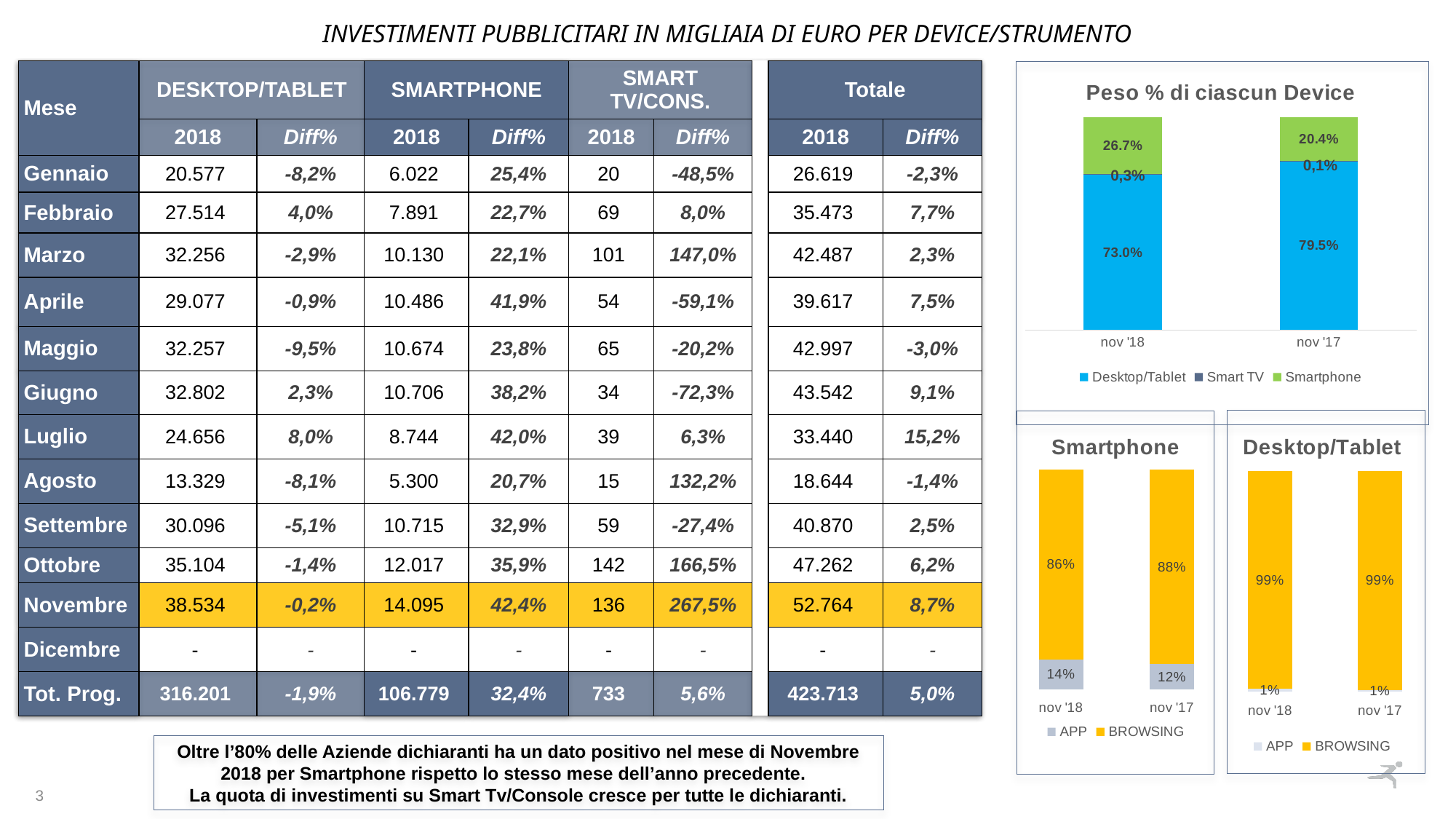
In the 'Desktop/Tablet' chart, how many bars are plotted? 2 In the 'Smartphone' chart, is the APP share larger in nov '18 or nov '17? nov '18 In the 'Desktop/Tablet' chart, what is the BROWSING share for nov '18? 99% In the 'Peso % di ciascun Device' chart, what is the Smartphone share for nov '17? 20.4% In the 'Peso % di ciascun Device' chart, what is the Smart TV share for nov '18? 0.3% In the 'Peso % di ciascun Device' chart, what is the Desktop/Tablet share for nov '18? 73.0% What type of chart is the 'Smartphone' chart? Stacked bar chart In the 'Peso % di ciascun Device' chart, how many series does the legend list? 3 In the 'Smartphone' chart, what is the APP share for nov '18? 14% In the 'Smartphone' chart, what is the BROWSING share for nov '17? 88% In the 'Peso % di ciascun Device' chart, by how many percentage points did the Smartphone share change from nov '17 to nov '18? 6.3 percentage points In the 'Peso % di ciascun Device' chart, which device has the largest share in nov '17? Desktop/Tablet